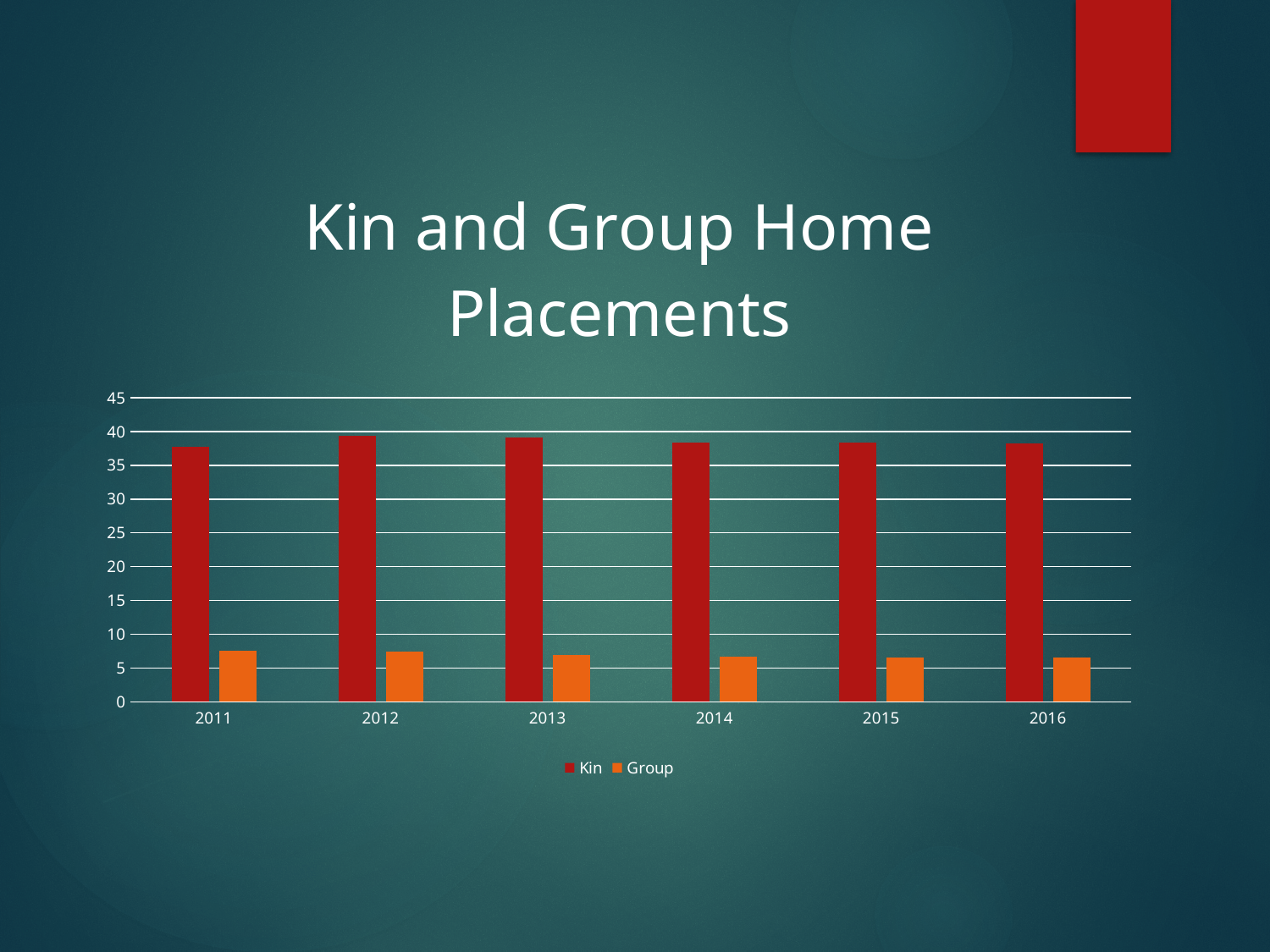
Is the Group value for 2011 greater or less than 5? greater Which series is shown in orange? Group Is the Group value for 2016 greater or less than 10? less Do the Group values rise or fall from 2011 to 2016? fall What is the title of the chart? Kin and Group Home Placements In 2013, which series has the larger value, Kin or Group? Kin What type of chart is shown on the slide? bar chart How many years are shown on the x axis? 6 Is the Kin value for 2016 greater or less than 30? greater How many series does the legend list? 2